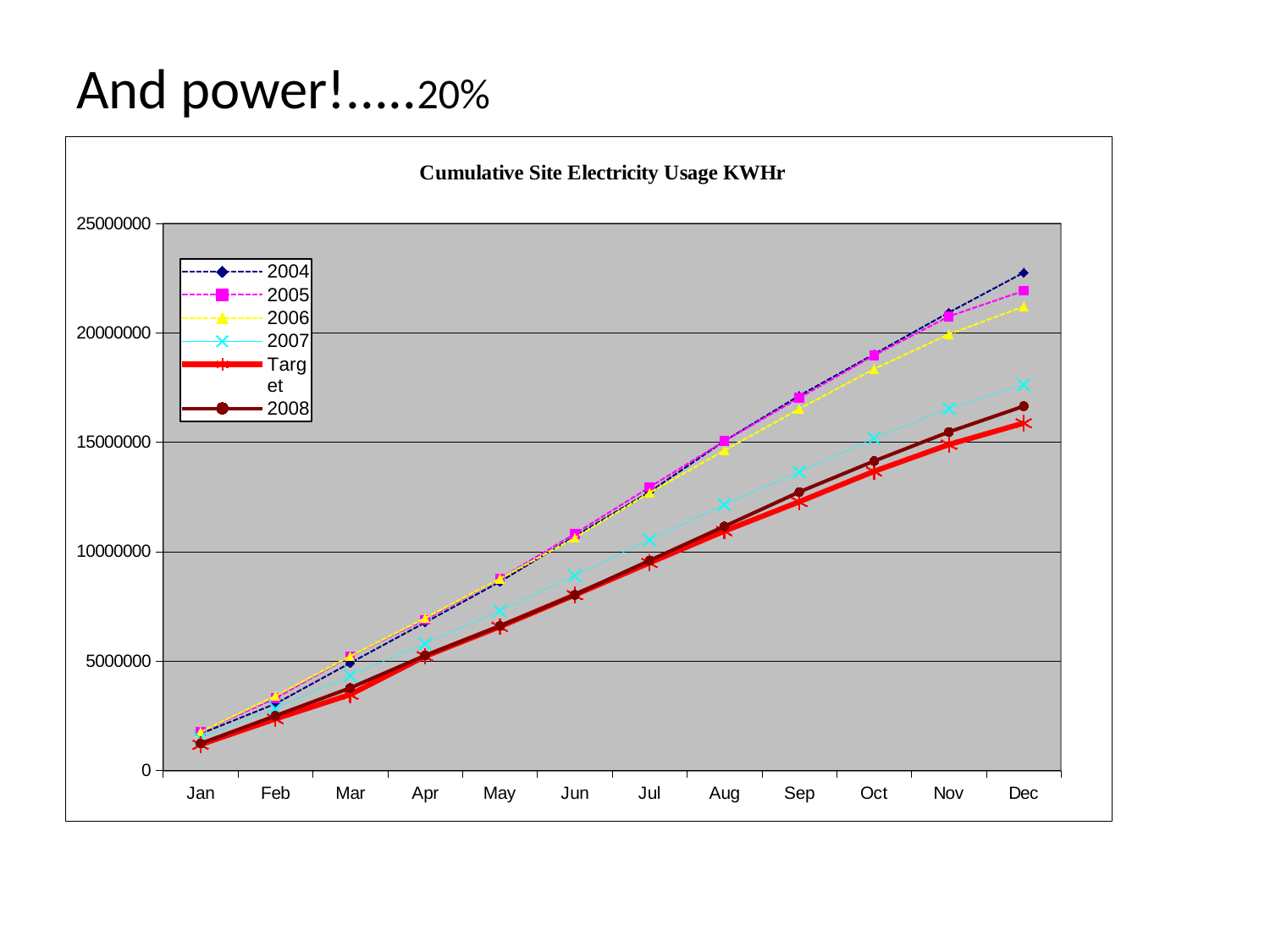
What kind of chart is shown on the slide? line chart Which series has the highest value in Dec? 2004 Is the value for 2004 in Dec greater or less than 20000000? greater Do the values for each series rise or fall from Jan to Dec? rise How many series does the chart legend list? 6 Is the value for 2007 in Jun greater or less than 10000000? less What is the title of the chart? Cumulative Site Electricity Usage KWHr Is the value for 2008 in Dec greater or less than 15000000? greater In Dec, which is larger, the value for 2004 or the value for 2007? 2004 How many months are shown along the x axis? 12 Which series has the lowest value in Dec? Target